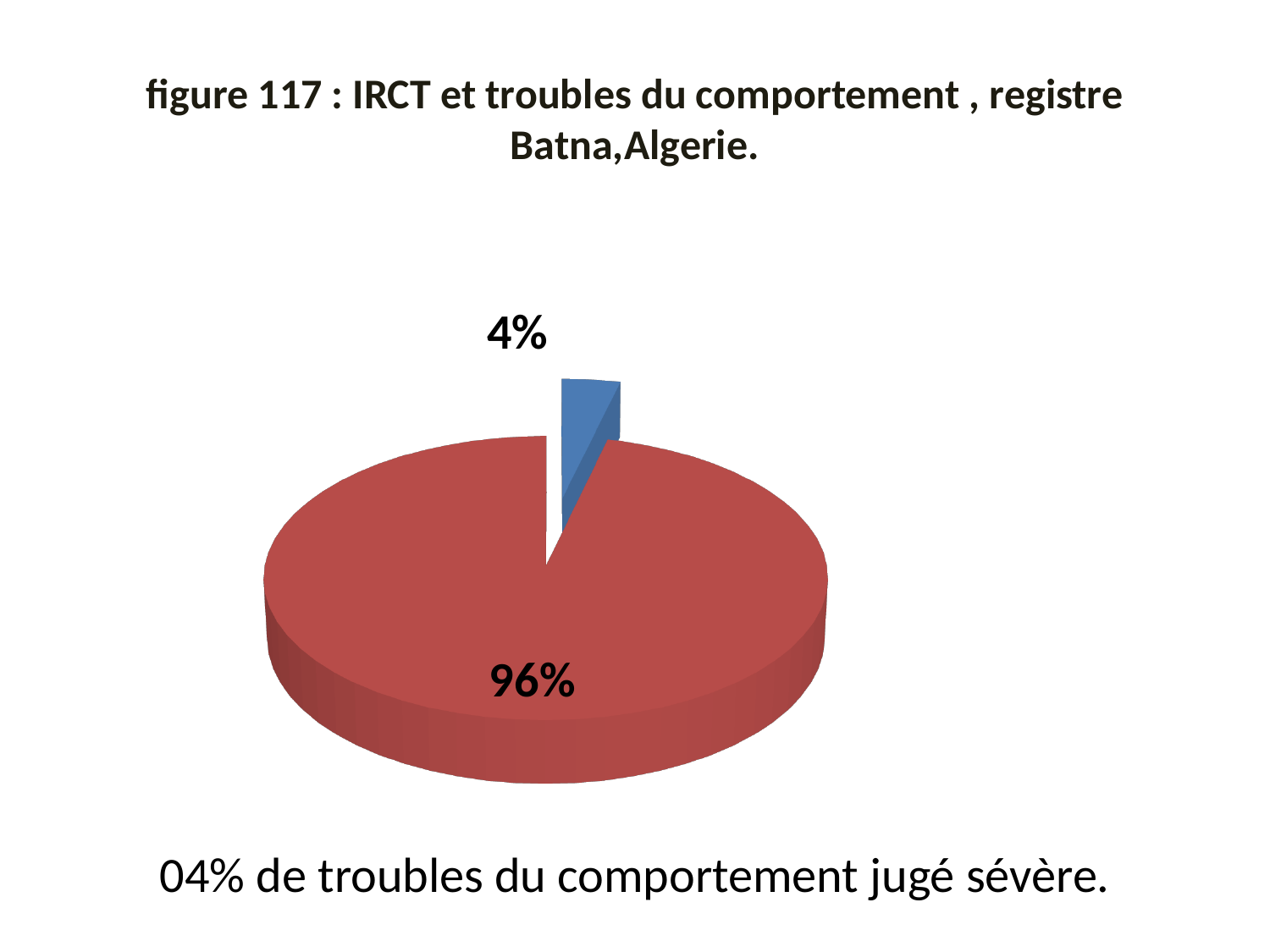
Which slice of the pie chart is the largest? the red slice (96%) Which slice of the pie chart is the smallest? the blue slice (4%) Which is larger, the blue slice or the red slice? the red slice What share of the pie does the blue slice represent? 4% What is the difference in percentage points between the red slice and the blue slice? 92 How many slices does the pie chart have? 2 What colour is the slice labelled 96%? red What percentage is shown on the blue slice of the pie chart? 4% What percentage is shown on the red slice of the pie chart? 96% What kind of chart is shown on the slide? pie chart What is the title of the chart? figure 117 : IRCT et troubles du comportement , registre Batna,Algerie.